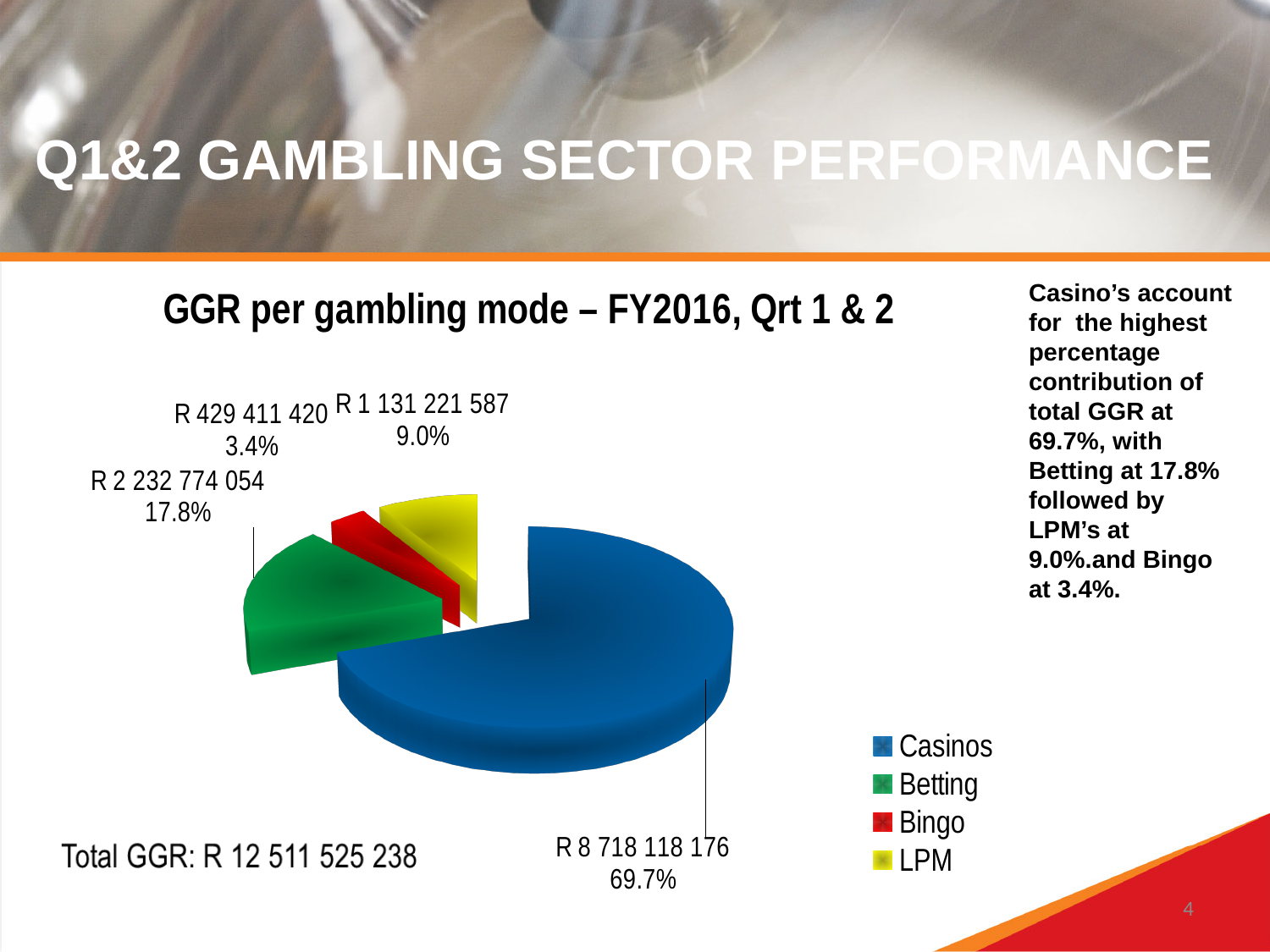
What is the GGR value for Casinos? R 8 718 118 176 What percentage share of the pie does Bingo represent? 3.4% What is the title of the chart? GGR per gambling mode – FY2016, Qrt 1 & 2 Which has a larger share of GGR, Betting or LPM? Betting What is the total GGR shown on the slide? R 12 511 525 238 What type of chart is shown on the slide? Pie chart How many gambling modes does the legend list? 4 Which gambling mode has the lowest GGR? Bingo What is the GGR value for Betting? R 2 232 774 054 What percentage share of total GGR do Casinos account for? 69.7% What is the GGR value for LPM? R 1 131 221 587 Which gambling mode has the highest GGR? Casinos